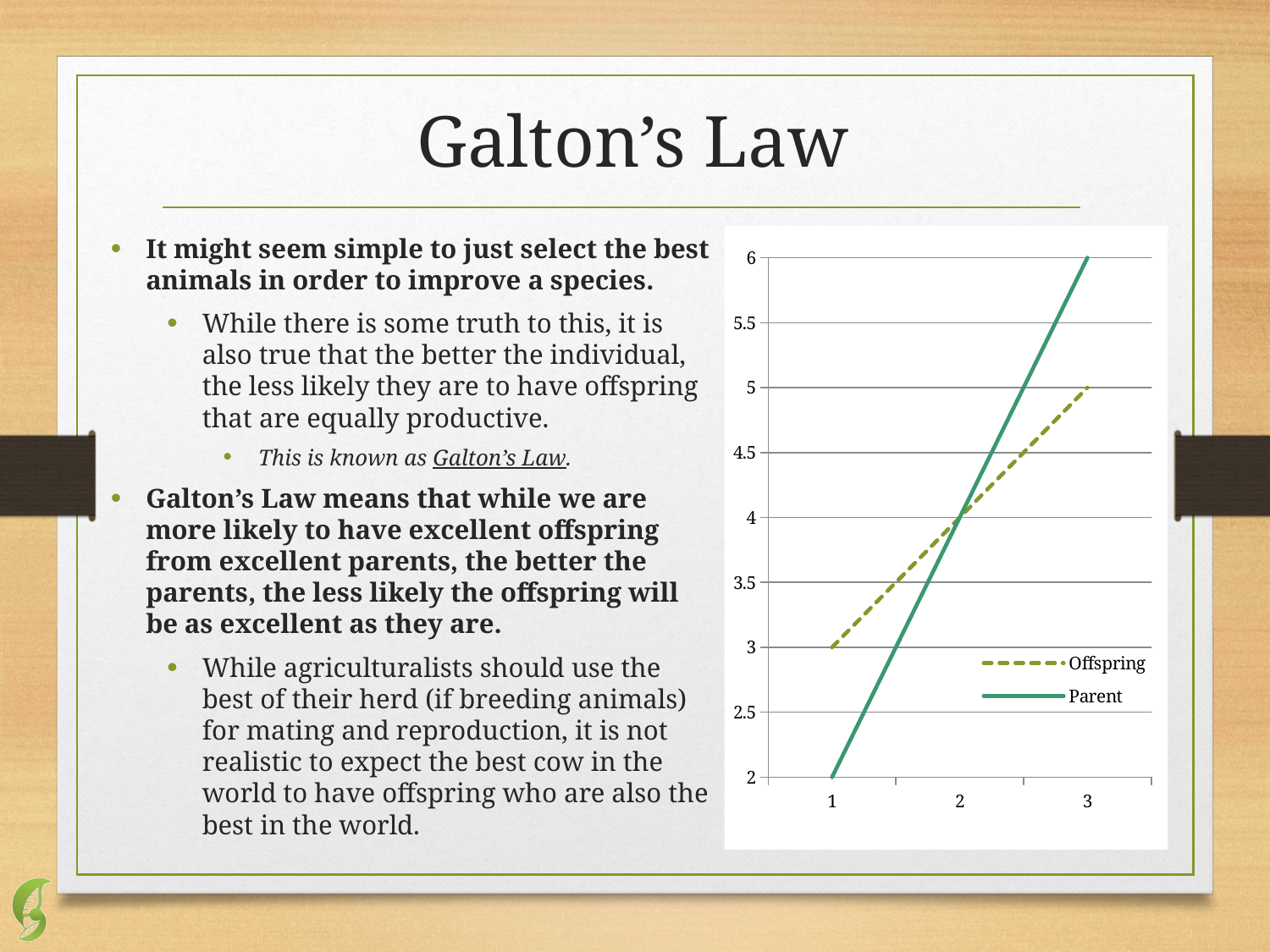
Which series has the higher value at x = 1, Offspring or Parent? Offspring How many points are plotted along the x axis for each series? 3 How many series does the chart legend list? 2 What kind of chart is shown on the slide? line chart Which series has the higher value at x = 3, Offspring or Parent? Parent What is the value of the Parent series at x = 1? 2 What is the value of the Offspring series at x = 1? 3 Do the values of the Parent series rise or fall as x increases from 1 to 3? rise What are the two series named in the chart legend? Offspring and Parent What is the value of the Parent series at x = 3? 6 What is the value of the Offspring series at x = 3? 5 Which series is drawn with a dashed line? Offspring